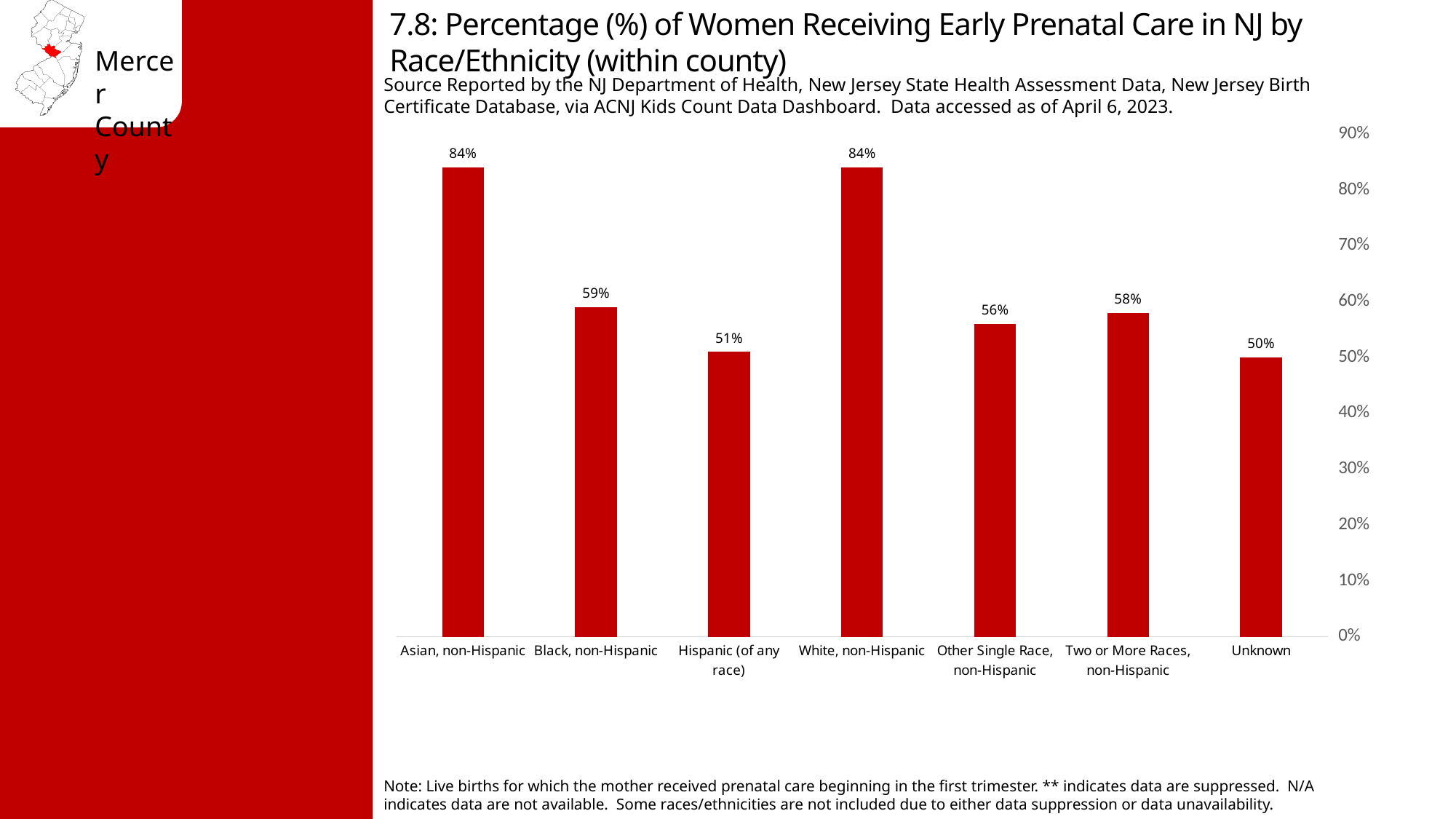
What is the value shown for Unknown? 50% Which is larger, the value for Black, non-Hispanic or the value for Hispanic (of any race)? Black, non-Hispanic Is the value for Other Single Race, non-Hispanic greater or less than 60%? less What is the value shown for Two or More Races, non-Hispanic? 58% How many race/ethnicity categories are plotted in the chart? 7 What is the value shown for Hispanic (of any race)? 51% What type of chart is shown on the slide? Bar chart What is the highest value shown on the vertical axis? 90% What is the difference between the values for White, non-Hispanic and Other Single Race, non-Hispanic? 28 percentage points What is the percentage of women receiving early prenatal care for Asian, non-Hispanic? 84% Which category has the lowest percentage of women receiving early prenatal care? Unknown What is the value shown for Black, non-Hispanic? 59%